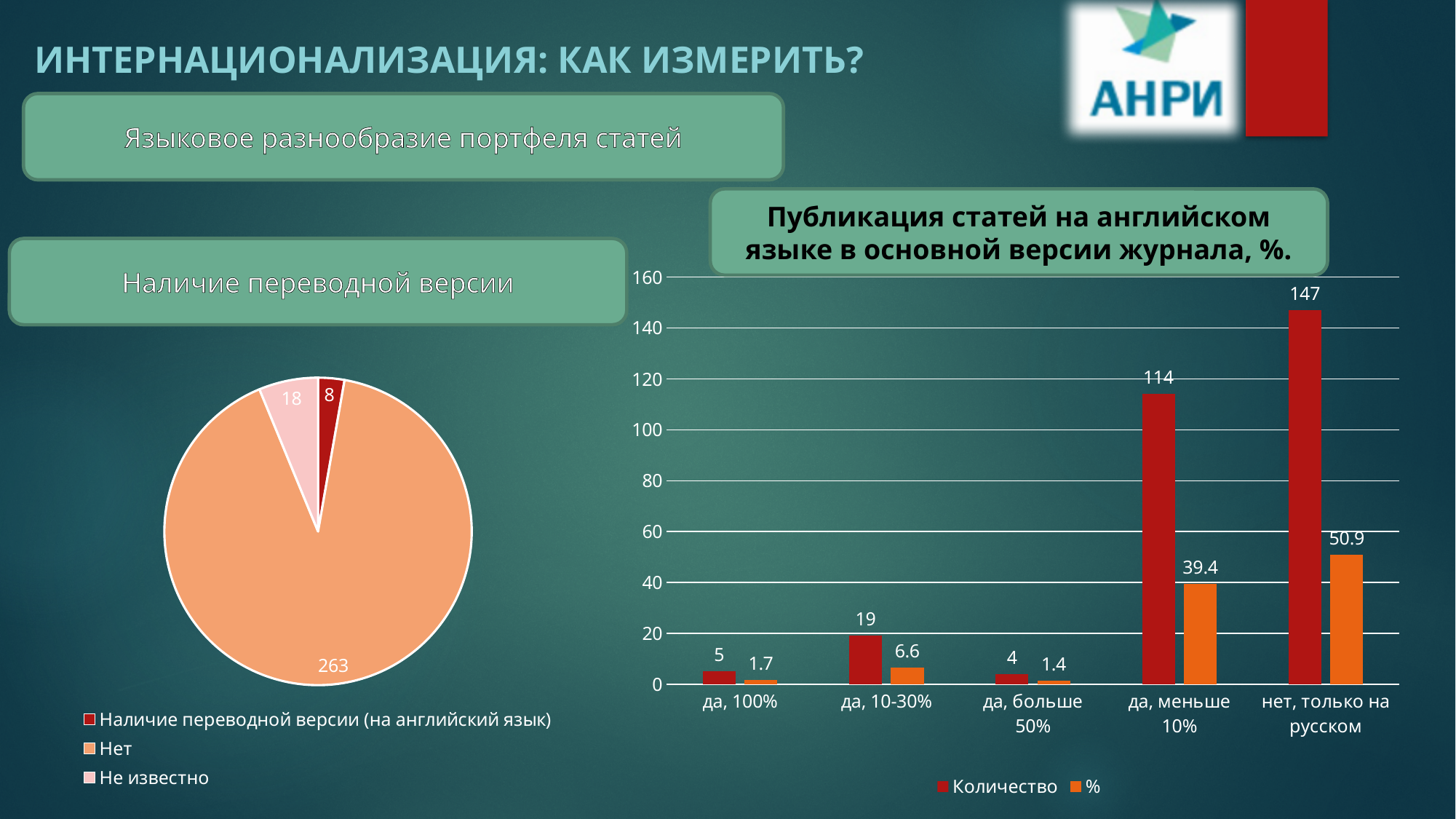
In the bar chart on the right, which category has the highest % value? нет, только на русском In the bar chart on the right, how many series does the legend list? 2 In the pie chart on the left, which slice is the smallest? Наличие переводной версии (на английский язык) In the pie chart on the left, what is the value of the 'Нет' slice? 263 In the bar chart on the right, what is the % value for 'да, меньше 10%'? 39.4 In the bar chart on the right, which category has the lowest Количество value? да, больше 50% In the bar chart on the right, what is the difference between the Количество values for 'нет, только на русском' and 'да, меньше 10%'? 33 In the bar chart on the right, which is larger: the Количество value for 'да, 100%' or for 'да, 10-30%'? да, 10-30% In the bar chart on the right, how many categories are shown on the x axis? 5 In the bar chart on the right, what is the Количество value for 'нет, только на русском'? 147 In the pie chart on the left, what is the total of all slices? 289 What type of chart is shown on the left side of the slide? pie chart